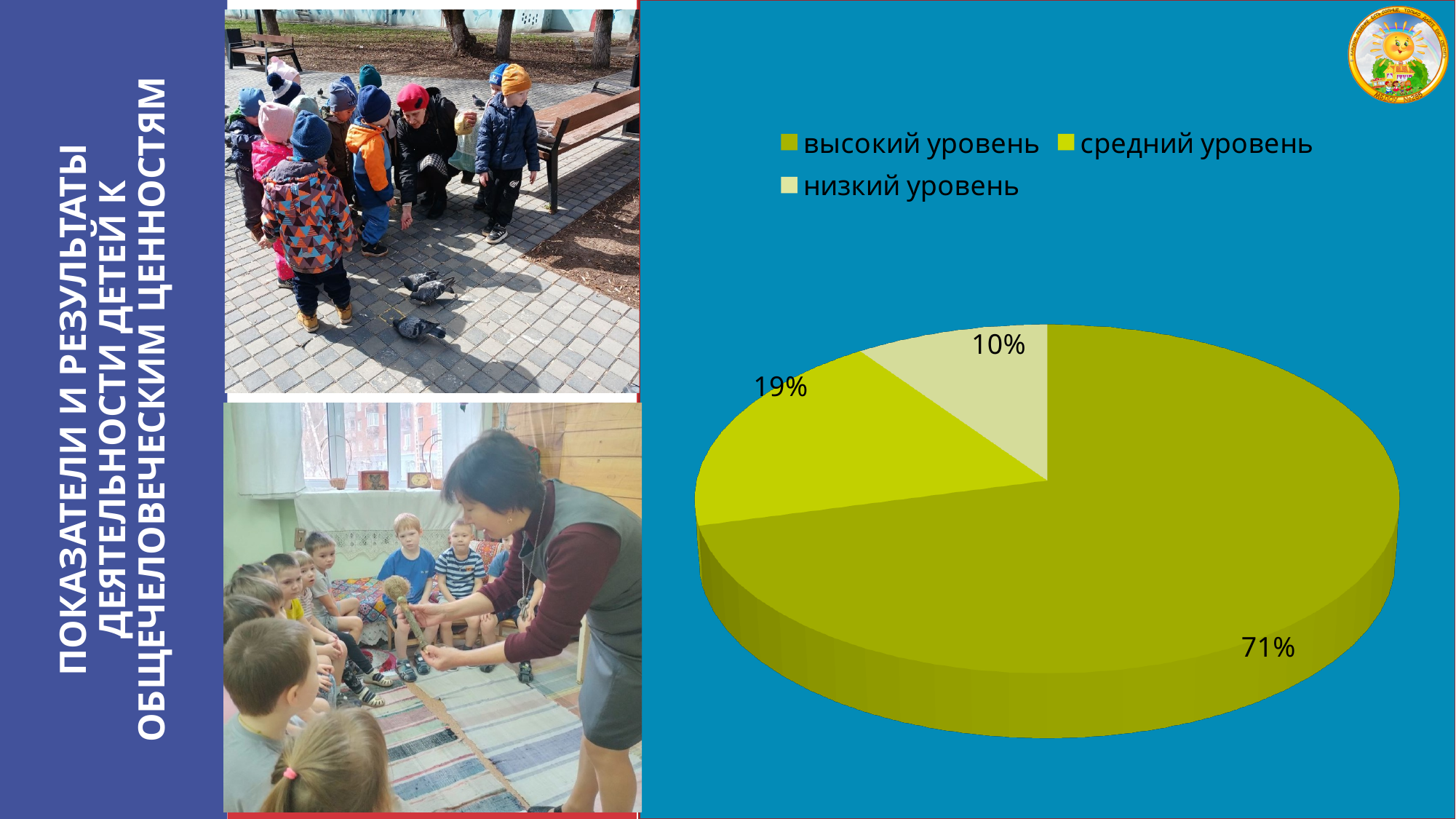
How many entries does the legend list? 3 What share of the pie does "высокий уровень" have? 71% What kind of chart is shown on the slide? pie chart Which category has the smallest slice of the pie? низкий уровень Which is larger: the slice for "средний уровень" or the slice for "низкий уровень"? средний уровень Which category has the largest slice of the pie? высокий уровень What is the difference between the shares of "высокий уровень" and "средний уровень"? 52% What share of the pie does "низкий уровень" have? 10% How many slices does the pie chart have? 3 What is the difference between the shares of "средний уровень" and "низкий уровень"? 9% Which legend entry is shown in the lightest colour? низкий уровень What share of the pie does "средний уровень" have? 19%